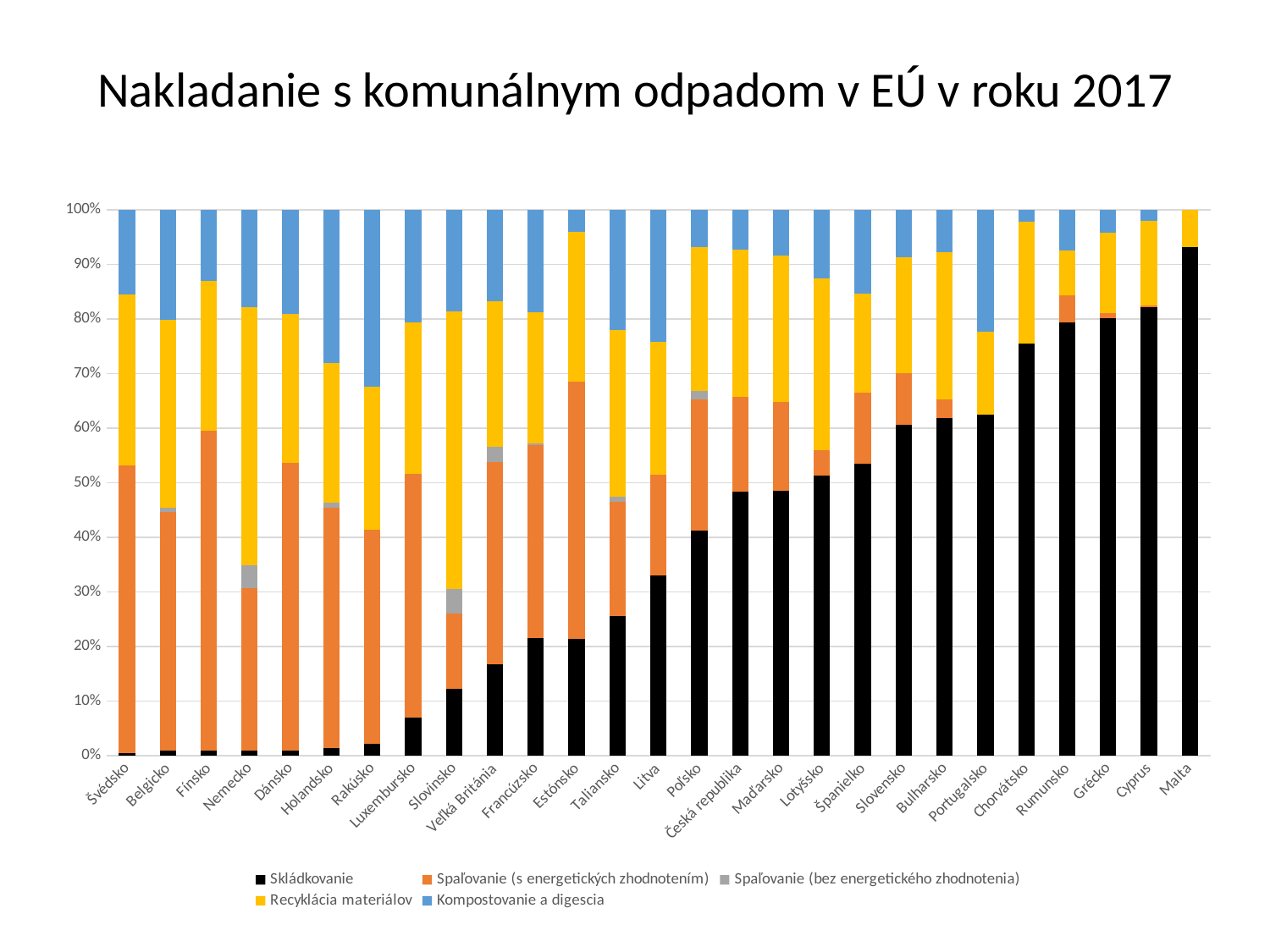
How many series does the legend list? 5 Is the Skládkovanie value for Malta greater or less than 90%? greater Which has a larger Skládkovanie share, Malta or Švédsko? Malta How many countries are shown on the x axis? 27 Is the Skládkovanie value for Švédsko greater or less than 10%? less What kind of chart is shown on the slide? stacked bar chart Which country has the highest share of Skládkovanie? Malta What is the total of the stacked bar for Švédsko? 100% Which colour represents Skládkovanie in the legend? black What is the title of the chart? Nakladanie s komunálnym odpadom v EÚ v roku 2017 Is the Skládkovanie value for Chorvátsko greater or less than 70%? greater Does the Skládkovanie share rise or fall moving from left to right along the x axis? rise